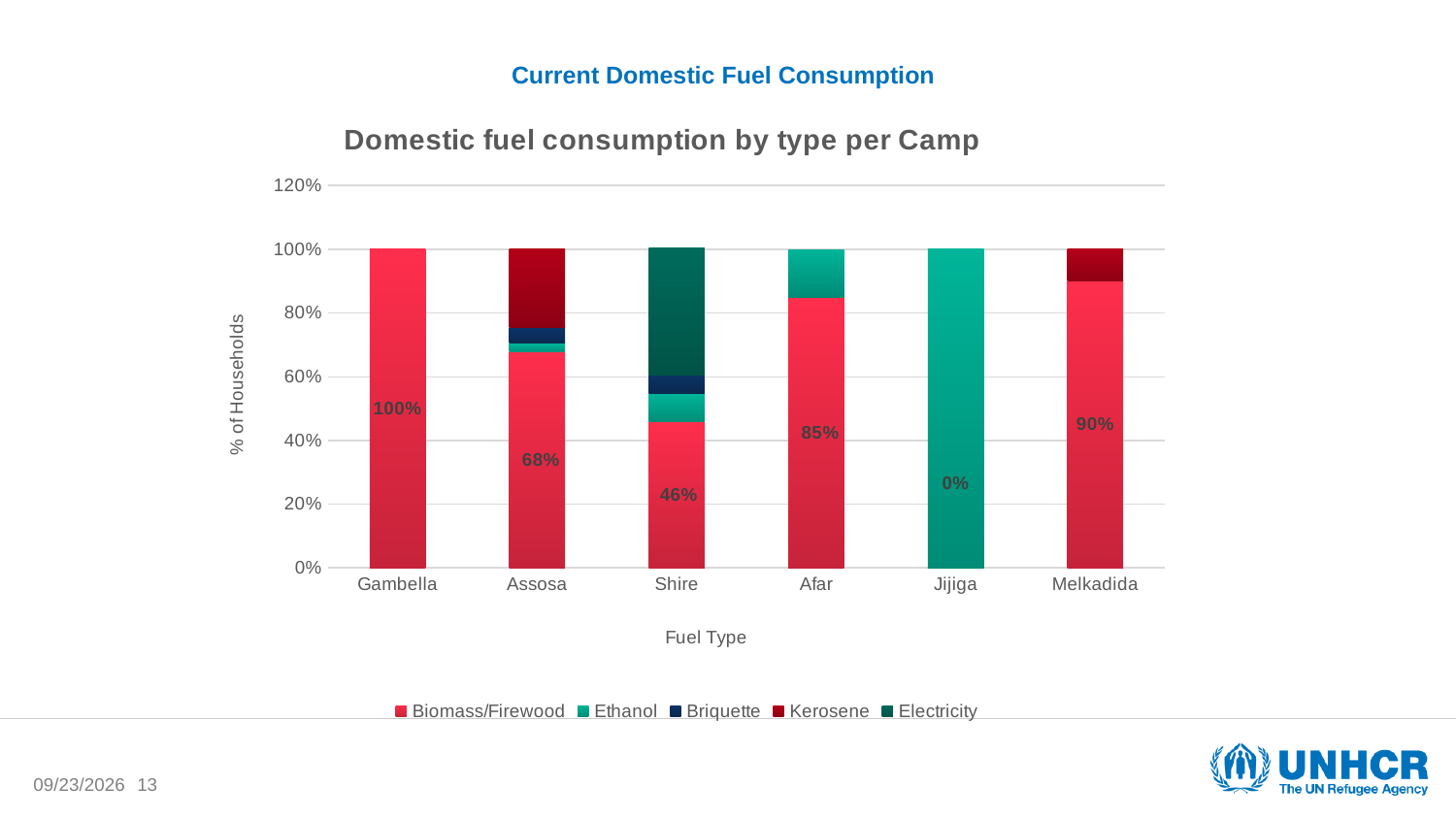
Which camp has the highest Biomass/Firewood value? Gambella What is the difference between the Biomass/Firewood values for Melkadida and Assosa? 22% What is the total height of the stacked bar for Gambella? 100% What is the Biomass/Firewood value for Afar? 85% What is the Biomass/Firewood value for Assosa? 68% What is the Biomass/Firewood value for Jijiga? 0% Which camp has a larger Biomass/Firewood value, Afar or Melkadida? Melkadida Which camp has the lowest Biomass/Firewood value? Jijiga What is the Biomass/Firewood value for Shire? 46% What kind of chart is shown on the slide? Stacked bar chart How many camps are shown on the x axis? 6 How many series does the legend list? 5